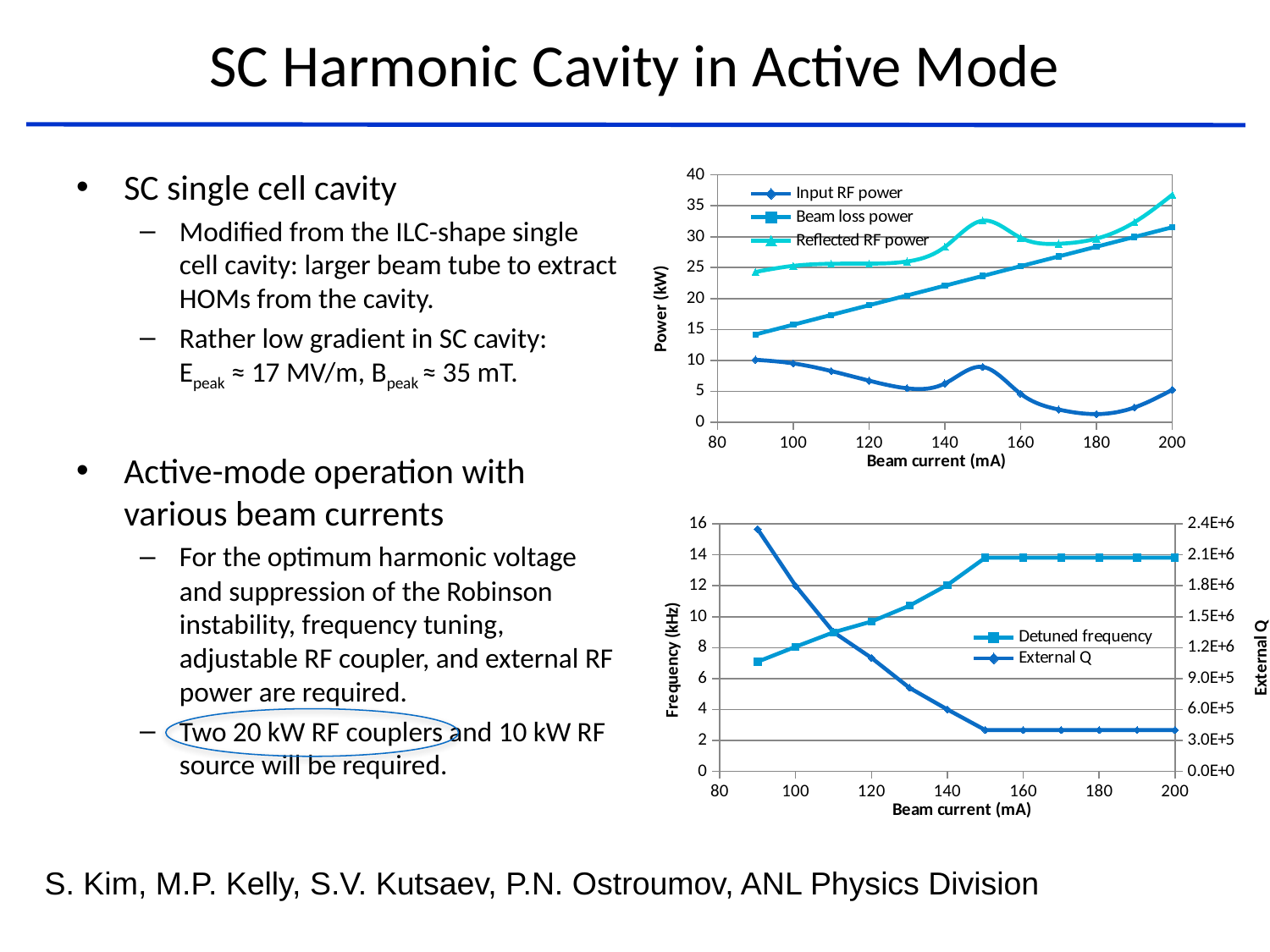
How many series does the legend of the bottom chart (Frequency / External Q vs Beam current) list? 2 In the bottom chart (Frequency / External Q vs Beam current), does External Q rise or fall as beam current increases from 90 to 150 mA? fall What kind of chart is the top chart (Power vs Beam current)? line chart In the top chart (Power vs Beam current), is the Input RF power at 90 mA greater or less than 5? greater In the top chart (Power vs Beam current), which series has the larger value at 200 mA: Reflected RF power or Input RF power? Reflected RF power How many series does the legend of the top chart (Power vs Beam current) list? 3 How many data points does the Beam loss power series have in the top chart (Power vs Beam current)? 12 What is the label of the right-hand vertical axis in the bottom chart? External Q In the bottom chart (Frequency / External Q vs Beam current), is the Detuned frequency at 90 mA greater or less than 8? less In the top chart (Power vs Beam current), is the Reflected RF power at 200 mA greater or less than 30? greater In the top chart (Power vs Beam current), does Beam loss power rise or fall as beam current increases? rise